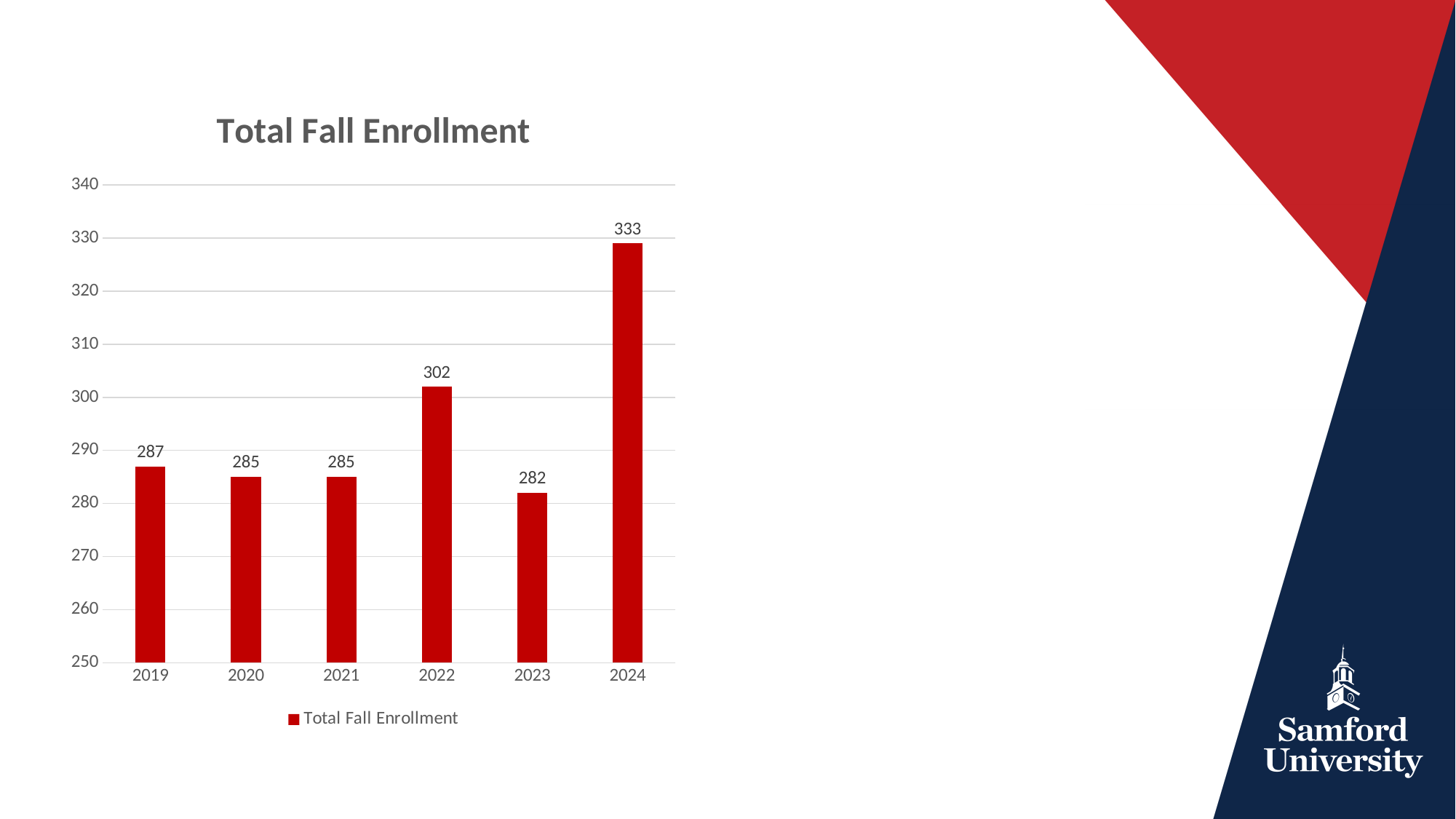
What is the Total Fall Enrollment for 2022? 302 What is the Total Fall Enrollment for 2024? 333 Is the Total Fall Enrollment for 2022 greater or less than 300? greater Which year has the highest Total Fall Enrollment? 2024 What kind of chart is shown on the slide? Bar chart How many years are shown on the x axis of the chart? 6 Which year has the lowest Total Fall Enrollment? 2023 What is the title of the chart? Total Fall Enrollment Which year has a larger Total Fall Enrollment, 2019 or 2023? 2019 What is the difference in Total Fall Enrollment between 2024 and 2023? 51 What is the difference in Total Fall Enrollment between 2022 and 2021? 17 What is the Total Fall Enrollment for 2019? 287